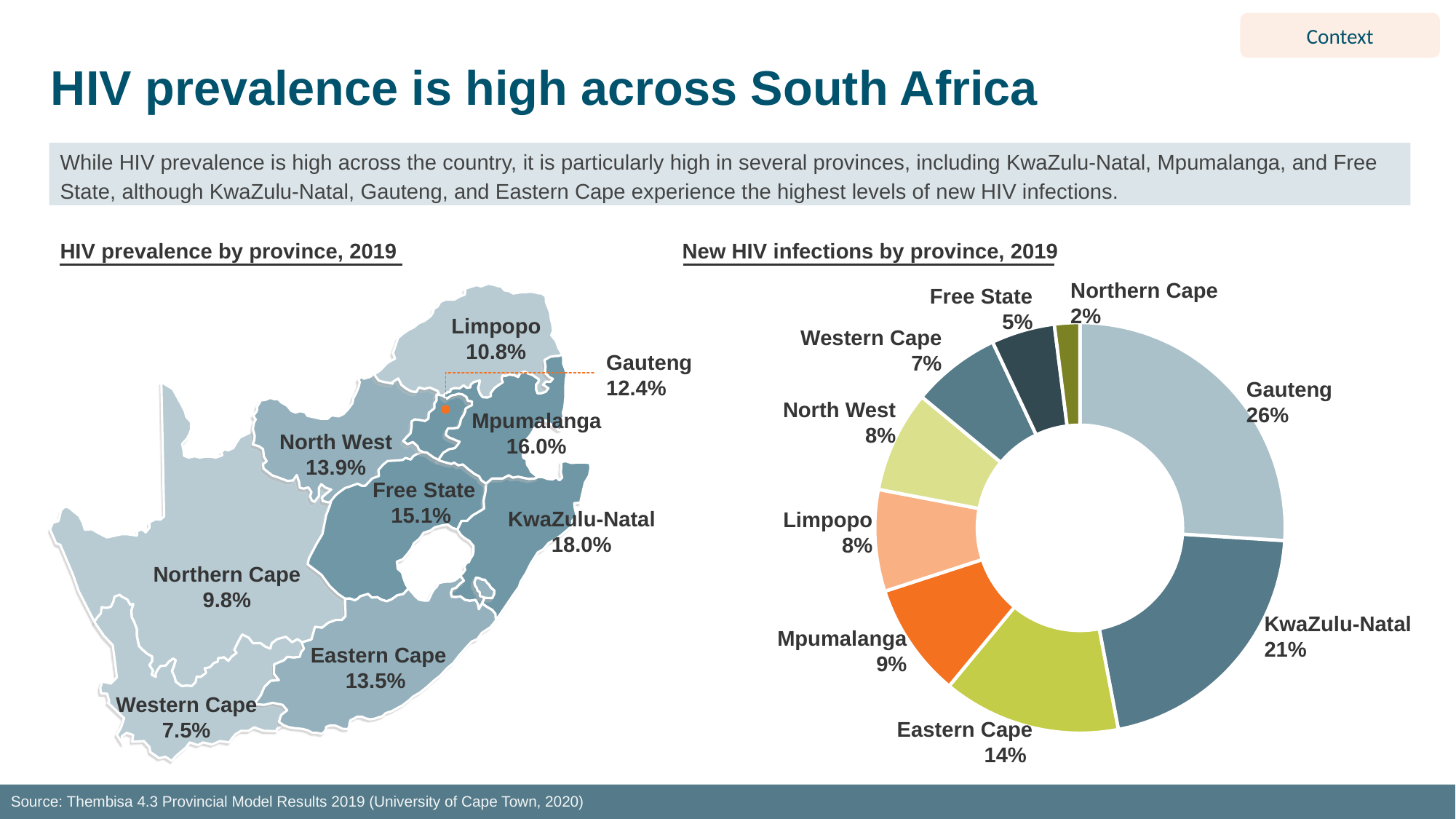
In the 'HIV prevalence by province, 2019' map, which province has higher HIV prevalence, North West or Eastern Cape? North West In the 'New HIV infections by province, 2019' chart, which province has the smallest share? Northern Cape In the 'New HIV infections by province, 2019' chart, what is the difference between the shares for Gauteng and KwaZulu-Natal? 5 percentage points How many provinces are shown in the 'New HIV infections by province, 2019' chart? 9 In the 'HIV prevalence by province, 2019' map, which province has the lowest HIV prevalence? Western Cape In the 'New HIV infections by province, 2019' chart, which has the larger share, Eastern Cape or Mpumalanga? Eastern Cape In the 'New HIV infections by province, 2019' chart, which province has the largest share? Gauteng What kind of chart is 'New HIV infections by province, 2019'? Donut (pie) chart In the 'New HIV infections by province, 2019' chart, what share of new infections is attributed to Gauteng? 26% In the 'New HIV infections by province, 2019' chart, what colour is the Mpumalanga slice? Orange In the 'HIV prevalence by province, 2019' map, what is the difference in prevalence between Mpumalanga and Free State? 0.9 percentage points In the 'HIV prevalence by province, 2019' map, what is the HIV prevalence in KwaZulu-Natal? 18.0%